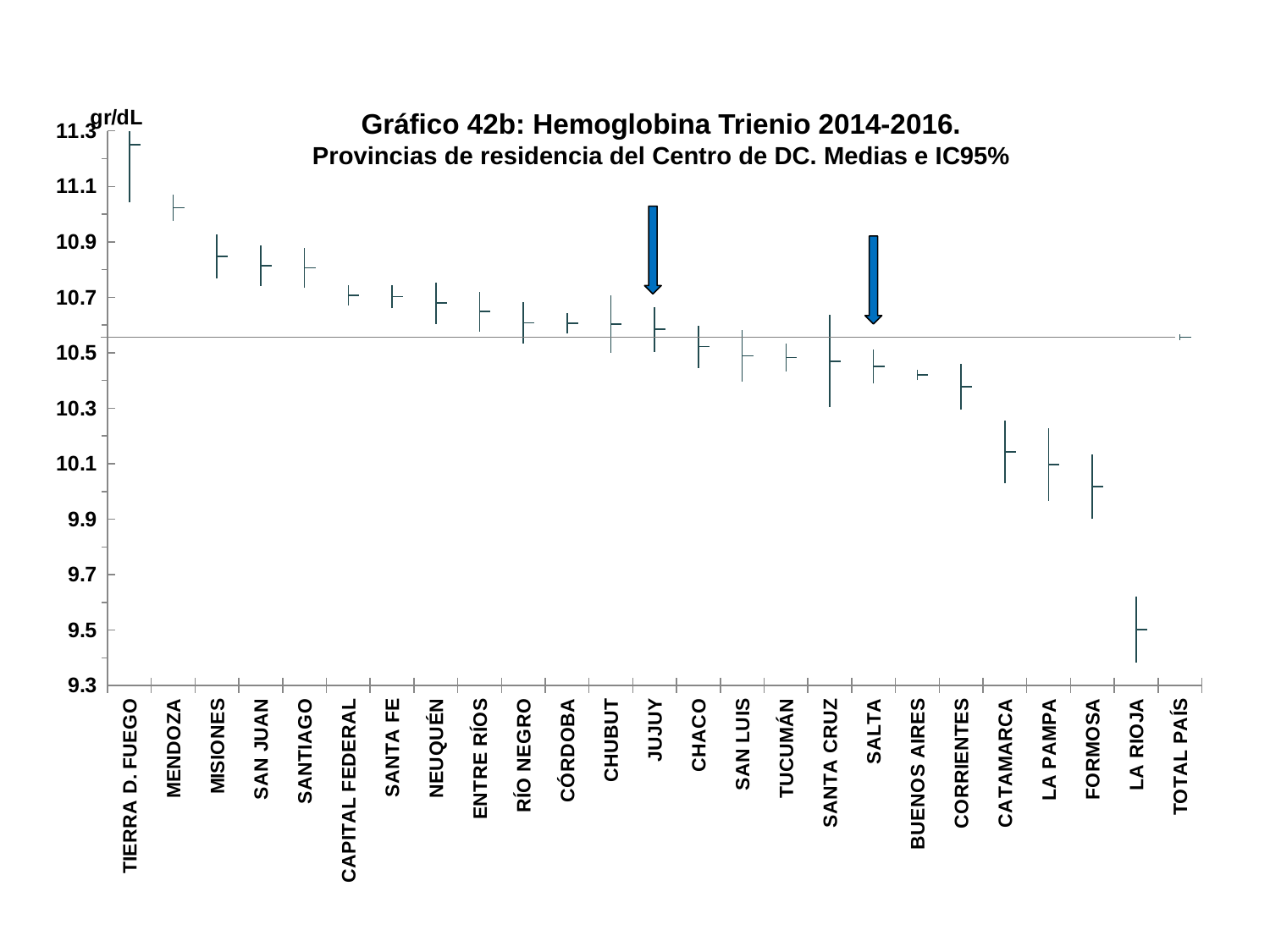
How many categories are shown along the x axis? 25 Is the mean value for TIERRA D. FUEGO greater or less than 11.1? greater Which has the larger mean value, MENDOZA or MISIONES? MENDOZA Is the mean value for MISIONES greater or less than 10.7? greater Is the mean value for LA RIOJA greater or less than 9.7? less Do the mean values rise or fall from left to right along the x axis? fall Which province has the lowest mean hemoglobin value on the chart? LA RIOJA Which has the larger mean value, CHACO or CATAMARCA? CHACO What unit is shown on the y axis of the chart? gr/dL Which province has the highest mean hemoglobin value on the chart? TIERRA D. FUEGO